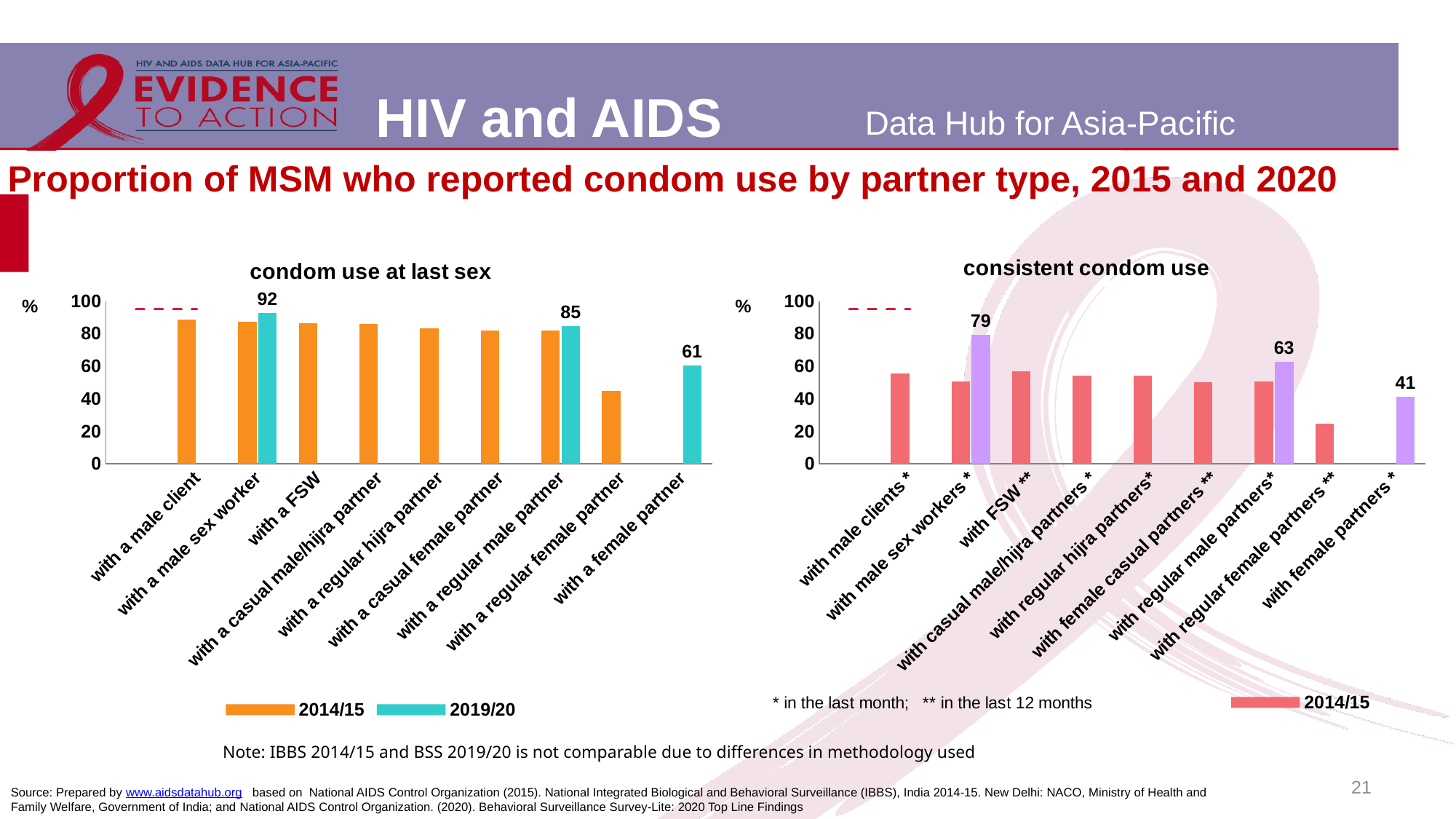
How many series does the legend of the 'condom use at last sex' chart list? 2 How many partner-type categories are shown on the x axis of the 'condom use at last sex' chart? 9 In the 'condom use at last sex' chart, what is the 2019/20 value for 'with a female partner'? 61 In the 'condom use at last sex' chart, what is the 2019/20 value for 'with a male sex worker'? 92 In the 'condom use at last sex' chart, what is the difference between the 2019/20 values for 'with a male sex worker' and 'with a female partner'? 31 In the 'consistent condom use' chart, what is the difference between the labelled values for 'with regular male partners*' and 'with female partners *'? 22 In the 'consistent condom use' chart, is the 2014/15 value for 'with regular female partners **' greater or less than 40? less In the 'condom use at last sex' chart, what is the 2019/20 value for 'with a regular male partner'? 85 In the 'condom use at last sex' chart, is the 2014/15 value for 'with a regular female partner' greater or less than 60? less In the 'consistent condom use' chart, what is the labelled value for 'with female partners *'? 41 In the 'condom use at last sex' chart, which category has the highest 2019/20 value? with a male sex worker In the 'consistent condom use' chart, what is the labelled value for 'with male sex workers *'? 79